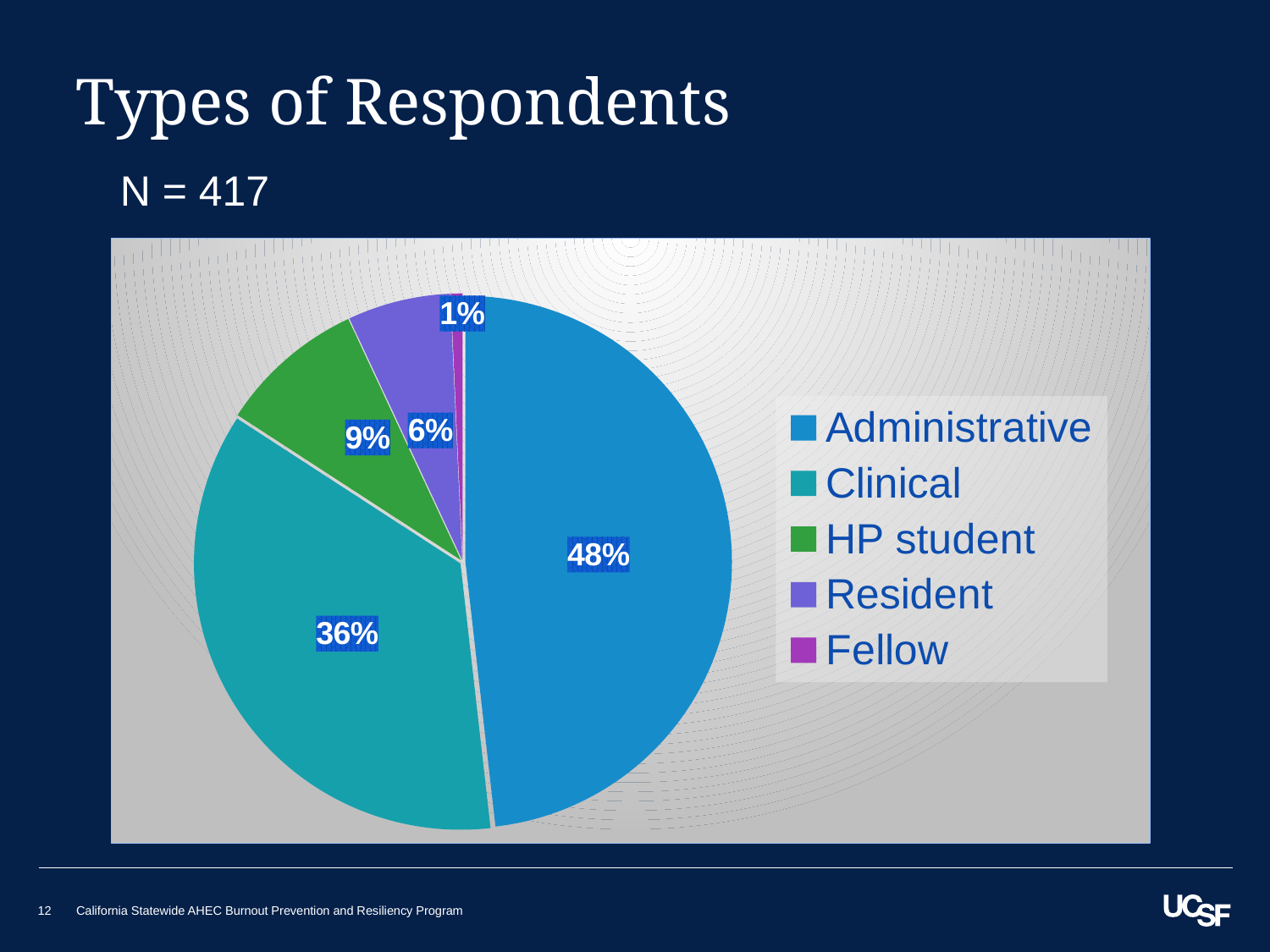
What share of respondents are Residents? 6% Which respondent type has the largest share of the pie? Administrative What share of respondents are Administrative? 48% What share of respondents are Clinical? 36% What is the difference in percentage points between the Administrative and Clinical shares? 12 How many categories does the legend list? 5 What share of respondents are Fellows? 1% Which respondent type has the smallest share of the pie? Fellow Which is larger, the HP student share or the Resident share? HP student What is the total number of respondents (N) stated on the slide? 417 What share of respondents are HP students? 9% What type of chart is shown on the slide? pie chart